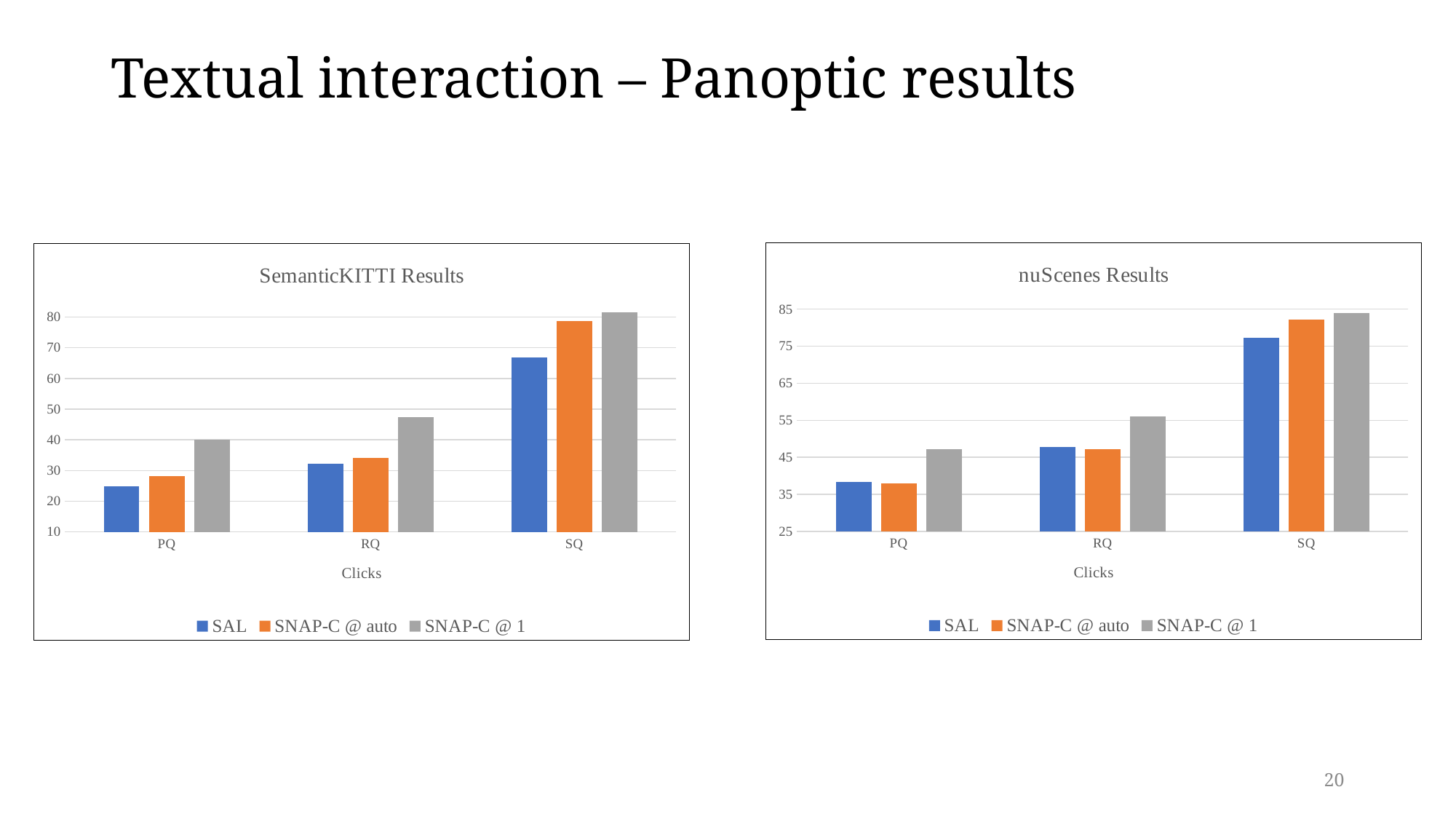
In the nuScenes Results chart, is the SAL value for SQ greater or less than 75? greater What is the x-axis title of the nuScenes Results chart? Clicks In the SemanticKITTI Results chart, is the SAL value for SQ greater or less than 70? less In the nuScenes Results chart, which is larger for SQ: SAL or SNAP-C @ auto? SNAP-C @ auto What kind of chart is the SemanticKITTI Results chart? bar chart In the SemanticKITTI Results chart, which series has the lowest value for PQ? SAL How many categories are shown on the x axis of the SemanticKITTI Results chart? 3 In the SemanticKITTI Results chart, which series has the highest value for SQ? SNAP-C @ 1 In the nuScenes Results chart, which series has the highest value for RQ? SNAP-C @ 1 How many series does the legend of the nuScenes Results chart list? 3 In the SemanticKITTI Results chart, do the SAL values rise or fall from PQ to SQ along the x axis? rise In the SemanticKITTI Results chart, is the SNAP-C @ 1 value for PQ greater or less than 30? greater